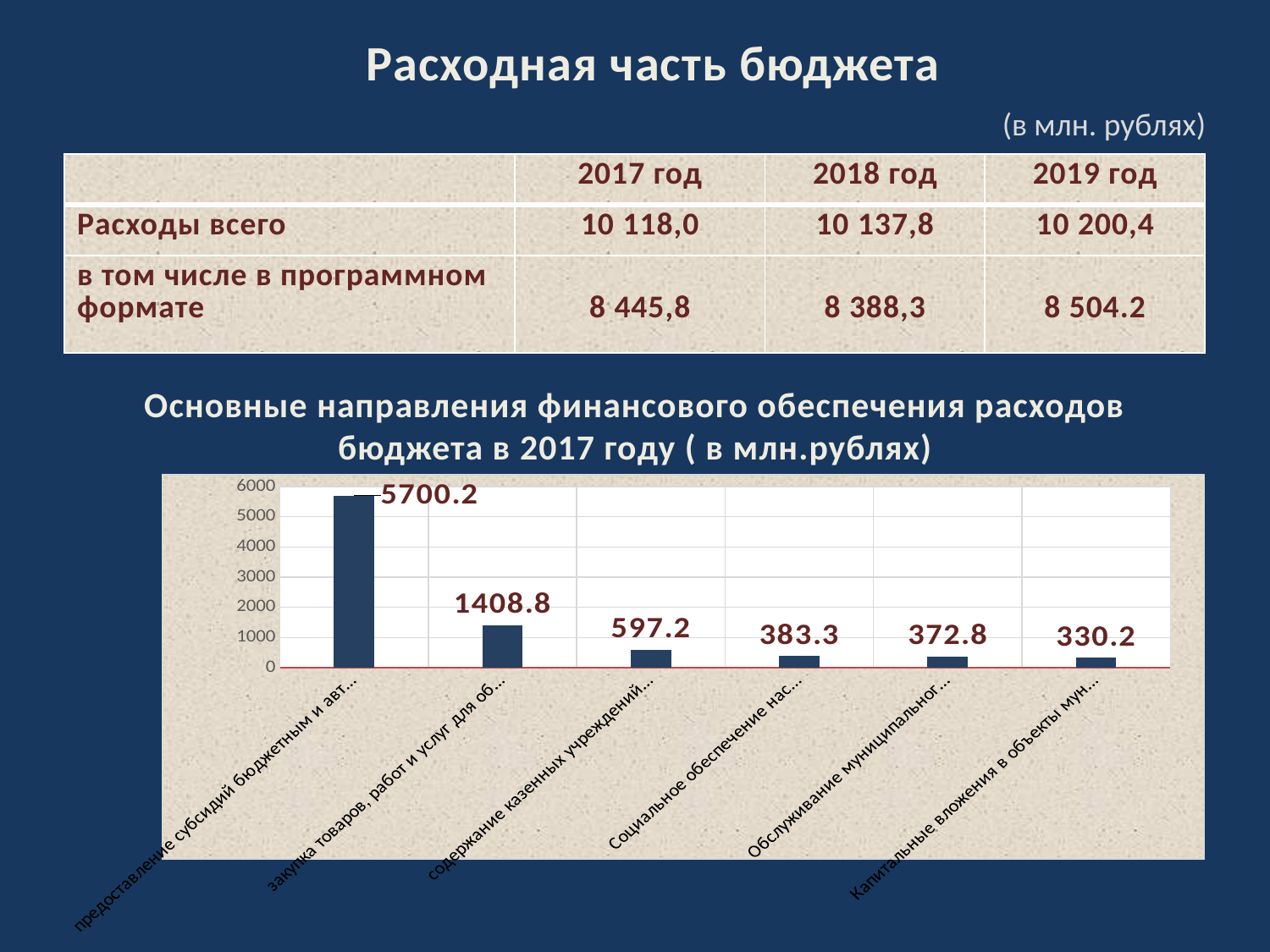
Which category has the highest value in the chart? предоставление субсидий бюджетным и авт... What is the value of the bar for "предоставление субсидий бюджетным и авт..."? 5700.2 What is the difference between the values for "предоставление субсидий бюджетным и авт..." and "закупка товаров, работ и услуг для об..."? 4291.4 What is the value of the bar for "содержание казенных учреждений..."? 597.2 Do the bar values rise or fall from left to right along the x axis? fall What type of chart is shown on the slide? bar chart Which category has the lowest value in the chart? Капитальные вложения в объекты мун... How many bars (categories) does the chart show? 6 What is the value of the bar for "Капитальные вложения в объекты мун..."? 330.2 Which is larger: the value for "содержание казенных учреждений..." or the value for "Обслуживание муниципального ..."? содержание казенных учреждений... What is the value of the bar for "Социальное обеспечение нас..."? 383.3 What is the value of the bar for "закупка товаров, работ и услуг для об..."? 1408.8